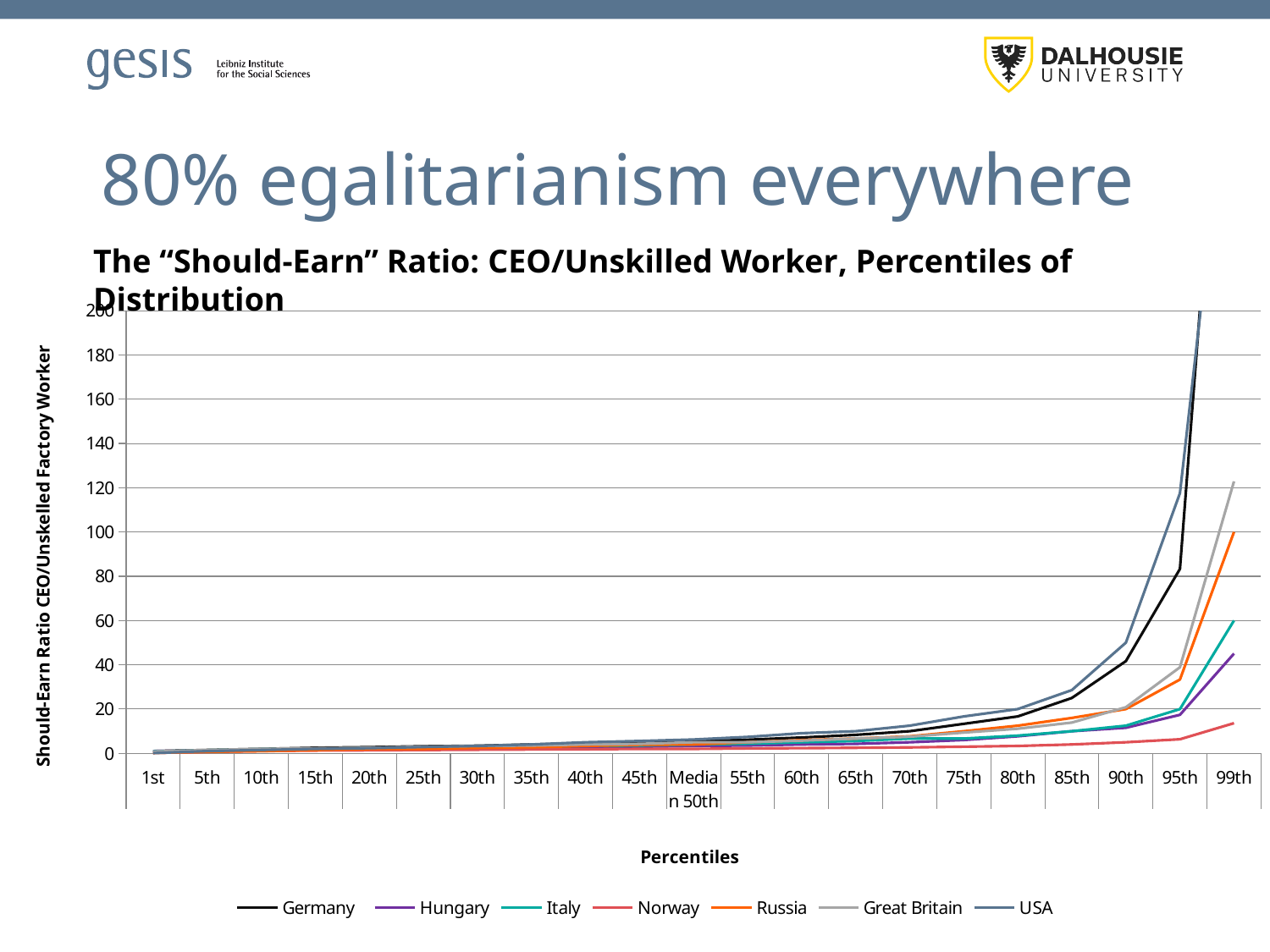
Which country has the highest value at the 95th percentile? USA What is the title of the x axis? Percentiles Is the value for USA at the 95th percentile greater or less than 100? greater What is the title of the chart? The “Should-Earn” Ratio: CEO/Unskilled Worker, Percentiles of Distribution How many percentile categories are shown on the x axis? 21 How many series does the legend list? 7 Which country has the lowest value at the 99th percentile? Norway Is the value for Great Britain at the 99th percentile greater or less than 100? greater Is the value for Norway at the 99th percentile greater or less than 20? less At the 95th percentile, which is larger: the value for Great Britain or the value for Italy? Great Britain What kind of chart is shown on the slide? line chart Do the values for USA rise or fall as the percentiles increase along the x axis? rise